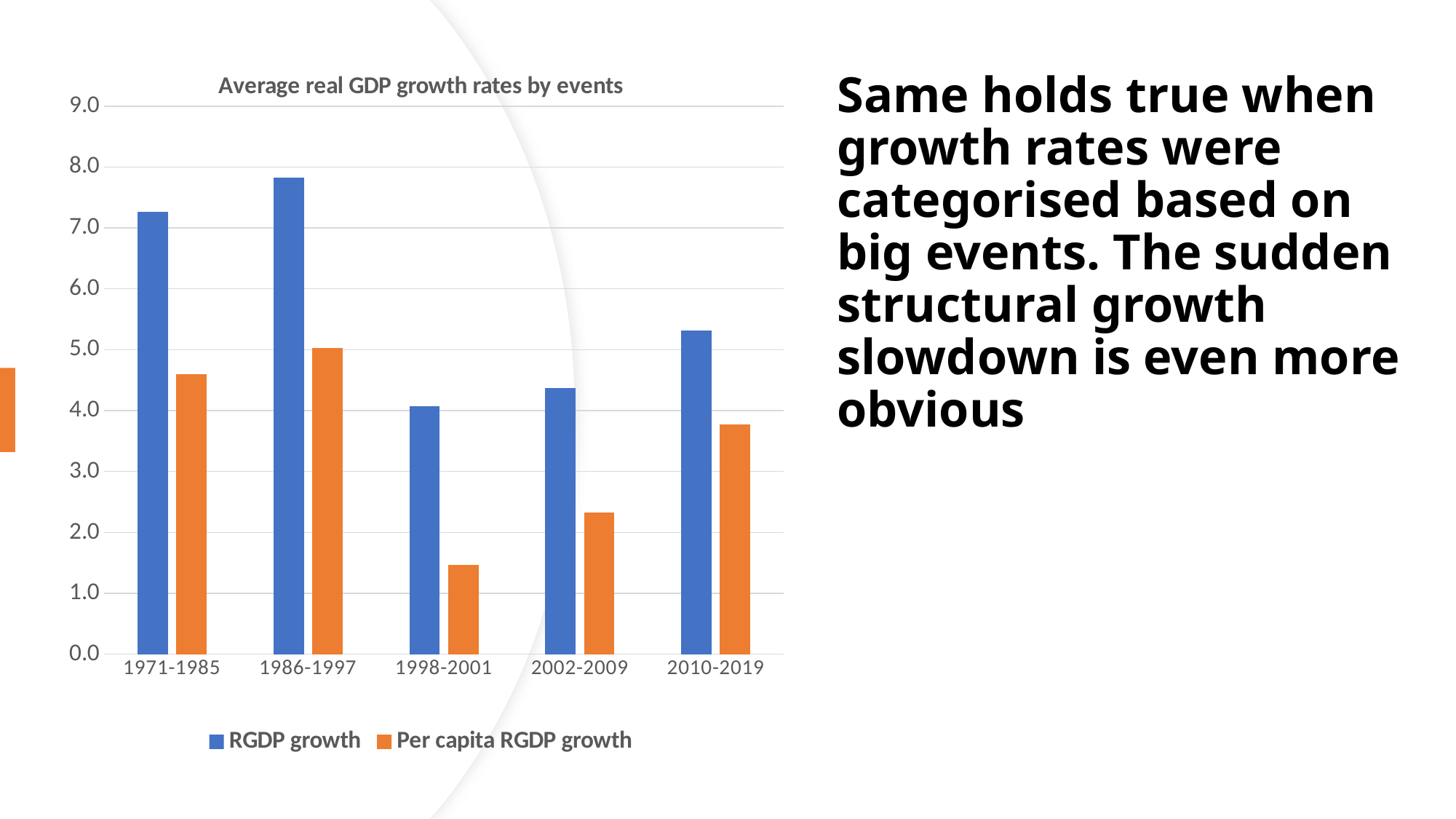
Is the RGDP growth value for 1971-1985 greater or less than 7.0? greater What is the title of the chart? Average real GDP growth rates by events Which is larger: RGDP growth for 1971-1985 or RGDP growth for 2010-2019? 1971-1985 How many period categories are shown on the x axis? 5 Which period has the highest RGDP growth? 1986-1997 Which period has the lowest Per capita RGDP growth? 1998-2001 Is the RGDP growth value for 2010-2019 greater or less than 5.0? greater Which colour represents Per capita RGDP growth in the chart? Orange Which period has the highest Per capita RGDP growth? 1986-1997 Is the Per capita RGDP growth value for 1998-2001 greater or less than 2.0? less How many series does the legend list? 2 What kind of chart is shown on the slide? Bar chart